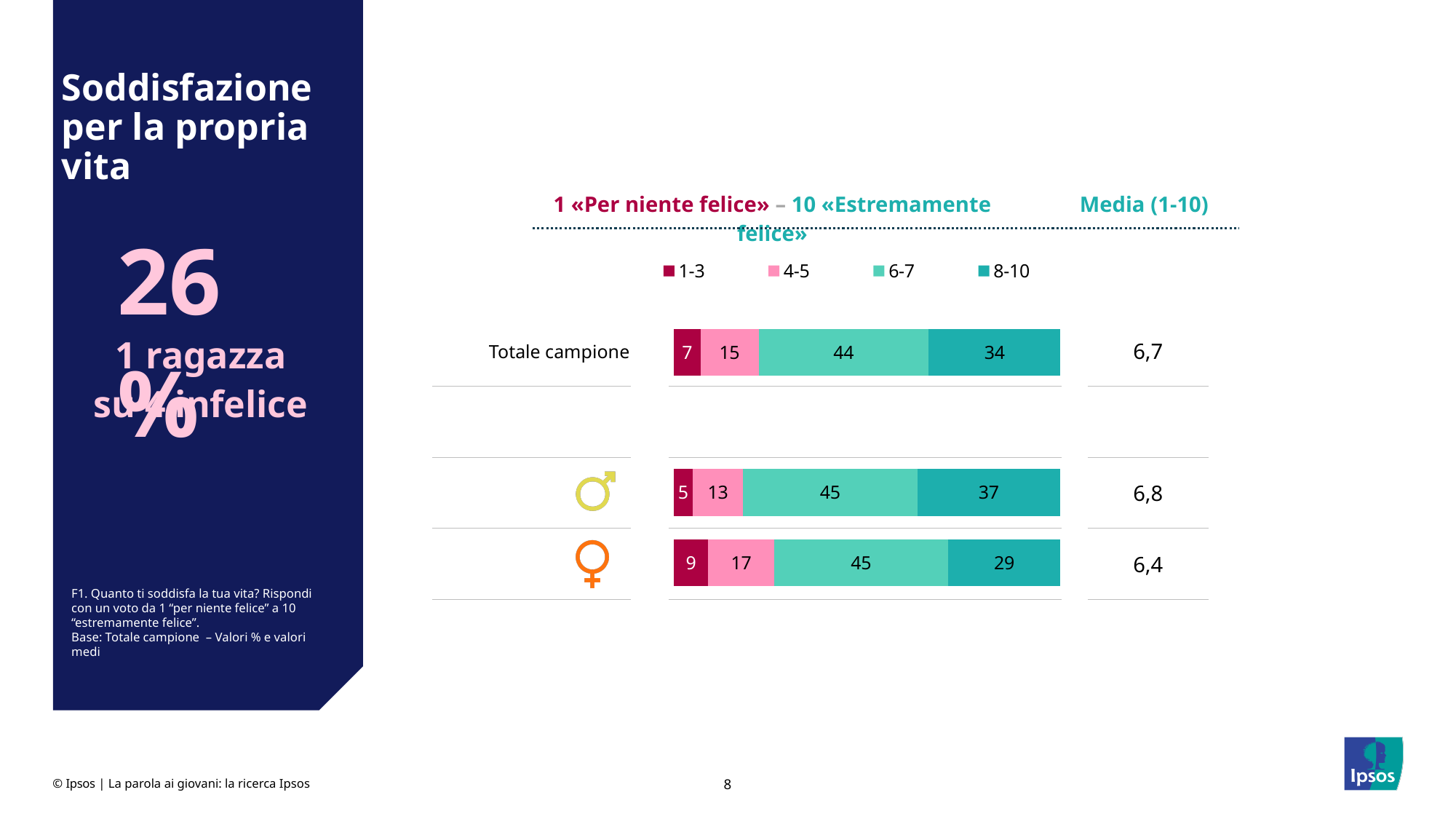
Which row has the lowest 1-3 value? male (♂) Which is larger: the 4-5 value for Totale campione or the 4-5 value for the female (♀) row? female (♀) row What is the value of the 6-7 segment for Totale campione? 44 What kind of chart is shown on the slide? stacked bar chart What is the Media (1-10) value for the female (♀) row? 6,4 Which row has the highest 8-10 value? male (♂) What is the value of the 8-10 segment in the male (♂) row? 37 What is the total of the stacked bar for Totale campione? 100 How many series does the legend list? 4 What is the difference between the 8-10 values of the male (♂) row and the female (♀) row? 8 What is the value of the 1-3 segment in the female (♀) row? 9 How many bars (rows) are plotted in the chart? 3